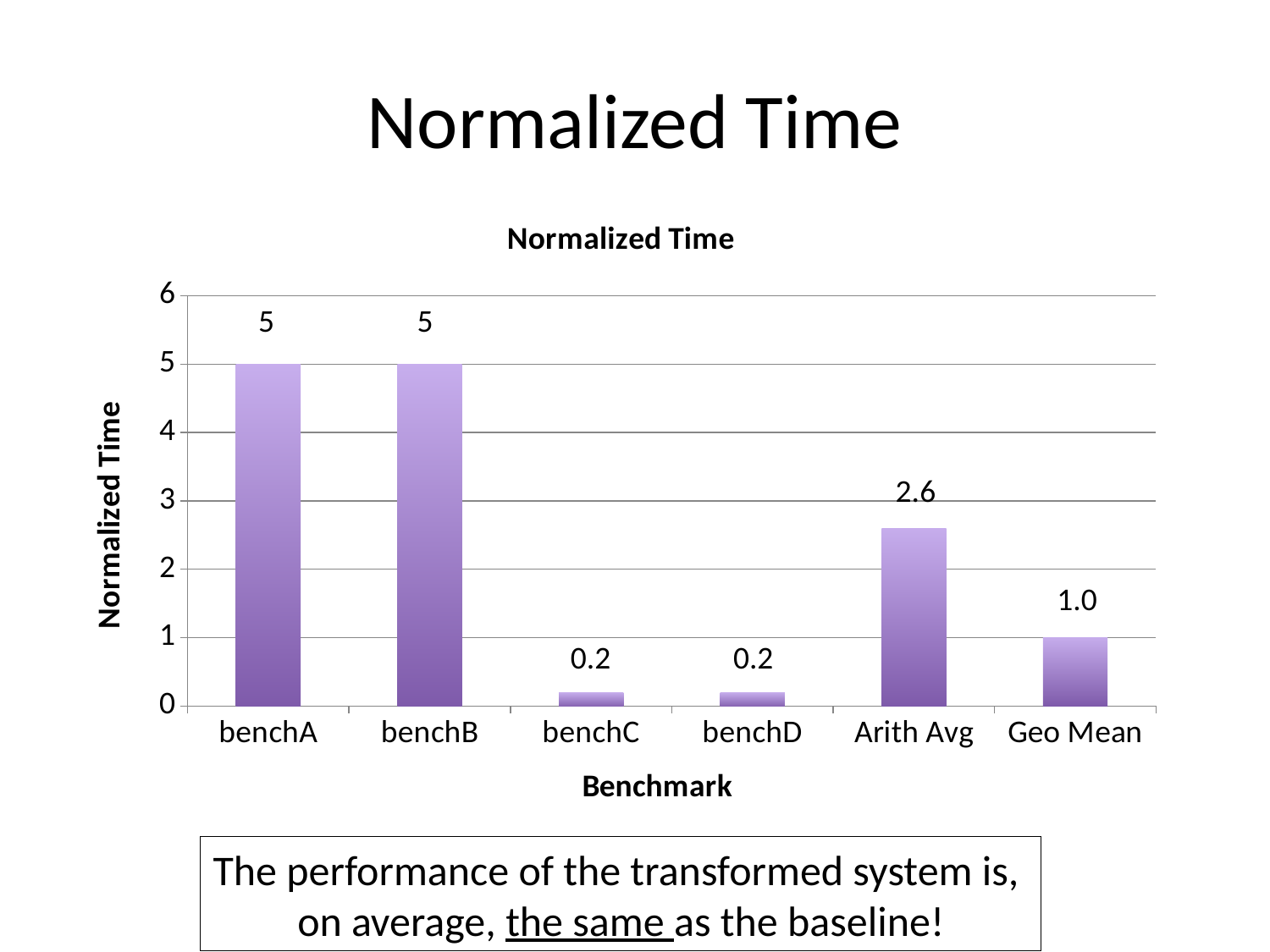
What is the normalized time for benchA? 5 What is the difference between the normalized time for Arith Avg and Geo Mean? 1.6 Which category has the lowest normalized time, Arith Avg or Geo Mean? Geo Mean What is the normalized time for benchC? 0.2 What is the difference between the normalized time for benchA and benchC? 4.8 What is the title of the chart? Normalized Time How many categories are shown on the x axis? 6 Is the value for Arith Avg greater or less than 2? greater What kind of chart is shown on the slide? bar chart What is the normalized time for Geo Mean? 1.0 What is the normalized time for Arith Avg? 2.6 What is the label of the x axis? Benchmark